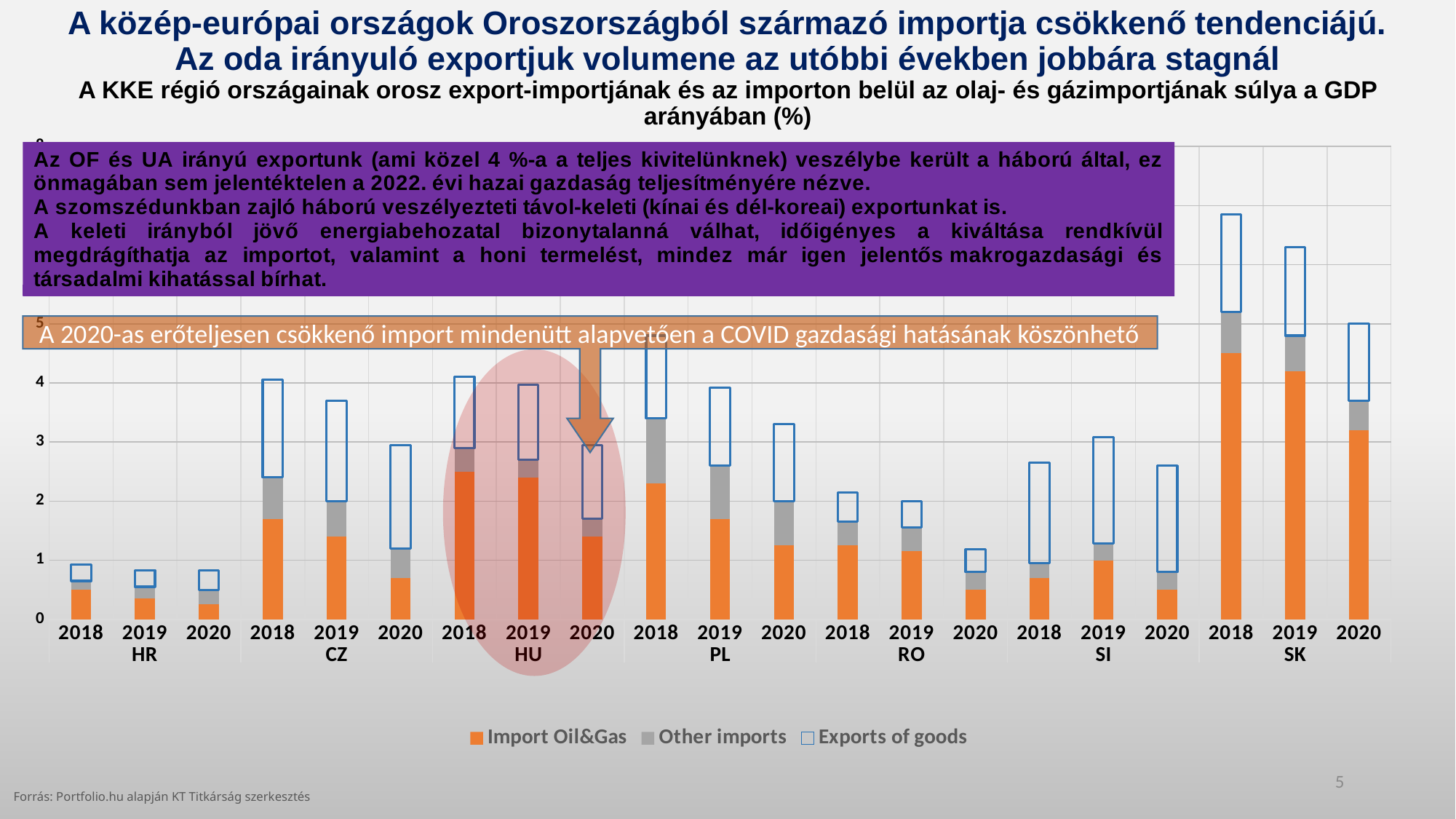
Is the Import Oil&Gas value for HR in 2018 greater or less than 1? less Which series are listed in the chart legend? Import Oil&Gas, Other imports, Exports of goods Which is larger, the Import Oil&Gas value for SK in 2018 or for HR in 2018? SK in 2018 Which country has the highest Import Oil&Gas value in 2018? SK Which years are shown for each country on the x axis? 2018, 2019, 2020 Is the Import Oil&Gas value for HU in 2018 greater or less than 2? greater Is the Import Oil&Gas value for SK in 2018 greater or less than 4? greater What kind of chart is shown on the slide? Stacked bar chart How many series does the chart legend list? 3 Does the Import Oil&Gas value for HU rise or fall from 2018 to 2020? fall How many countries are shown on the x axis of the chart? 7